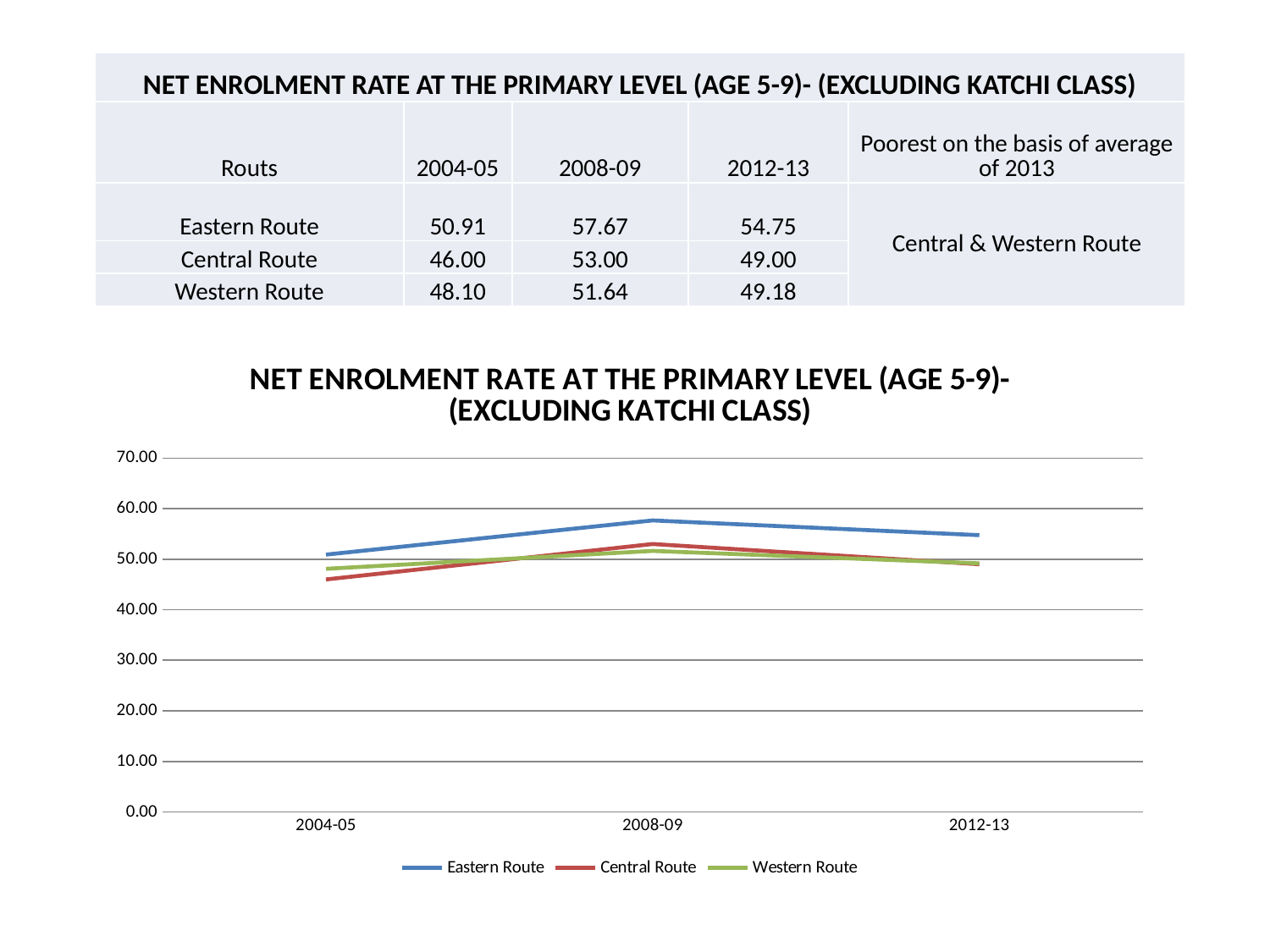
Which route has the lowest value in 2004-05? Central Route What is the difference between Eastern Route and Central Route in 2012-13? 5.75 What is the value for Eastern Route in 2008-09? 57.67 Which is larger in 2004-05, Eastern Route or Western Route? Eastern Route What is the value for Western Route in 2012-13? 49.18 Does the Eastern Route line rise or fall from 2008-09 to 2012-13? fall How many series does the chart legend list? 3 How many points are on the x axis of the chart? 3 What is the value for Central Route in 2004-05? 46.00 Which route has the highest value in 2008-09? Eastern Route What type of chart is shown on the slide? line chart Is the value for Eastern Route in 2008-09 greater or less than 50.00? greater